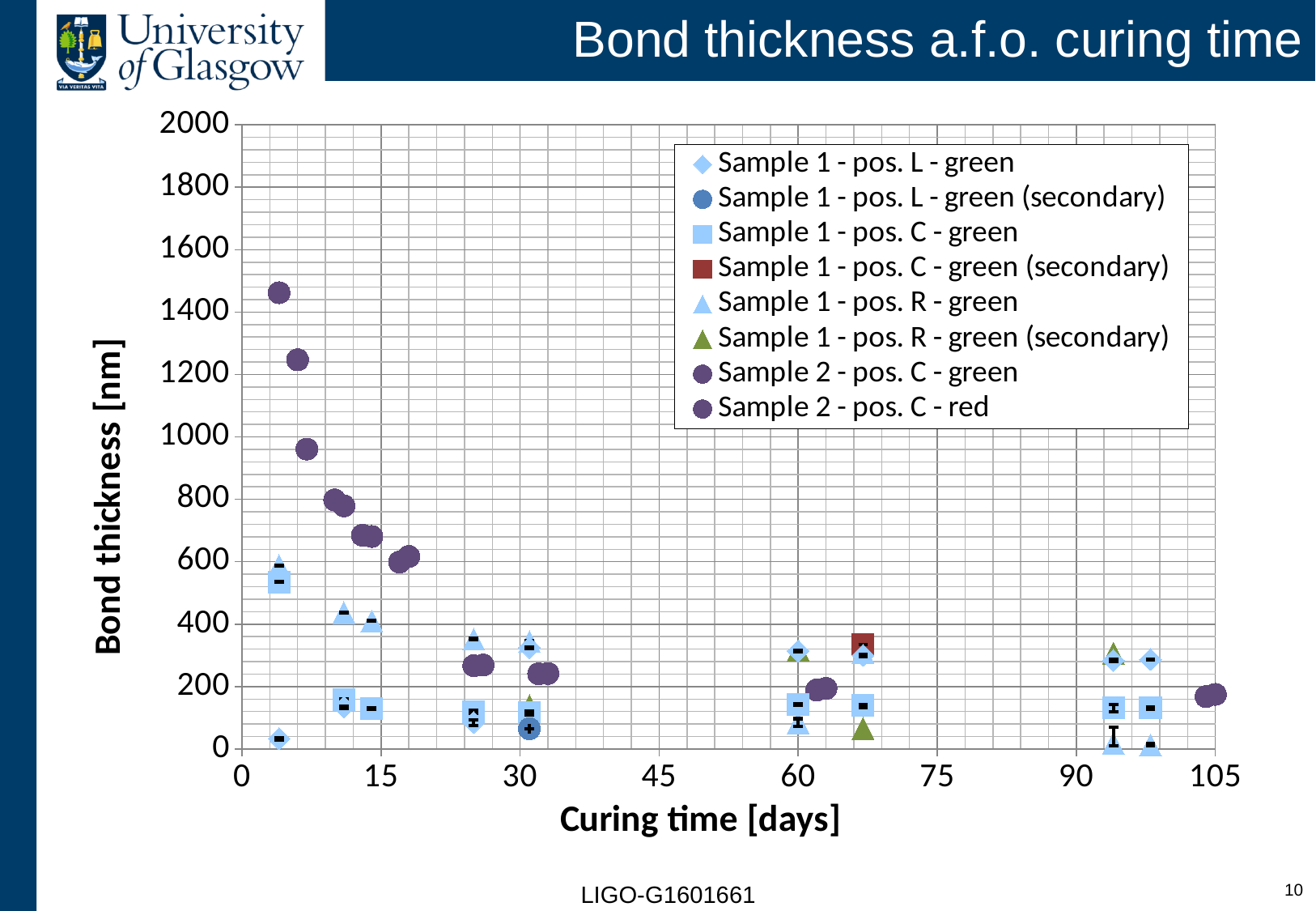
Is the value of the Sample 1 - pos. C - green (secondary) point (red square) greater or less than 400? less What is the title of the chart's x axis? Curing time [days] Is the highest plotted bond thickness value greater or less than 1400? greater Is the purple circle point plotted at about 4 days larger or smaller than the purple circle point plotted at about 18 days? larger What is the highest tick value shown on the y axis? 2000 How many series does the legend list? 8 Is the value of the Sample 1 - pos. L - green (secondary) point (dark blue circle) greater or less than 200? less Do the purple circle (Sample 2) values rise or fall as curing time increases? fall What kind of chart is shown on the slide? scatter chart What is the title of the chart's y axis? Bond thickness [nm] How many legend entries contain the word "secondary"? 3